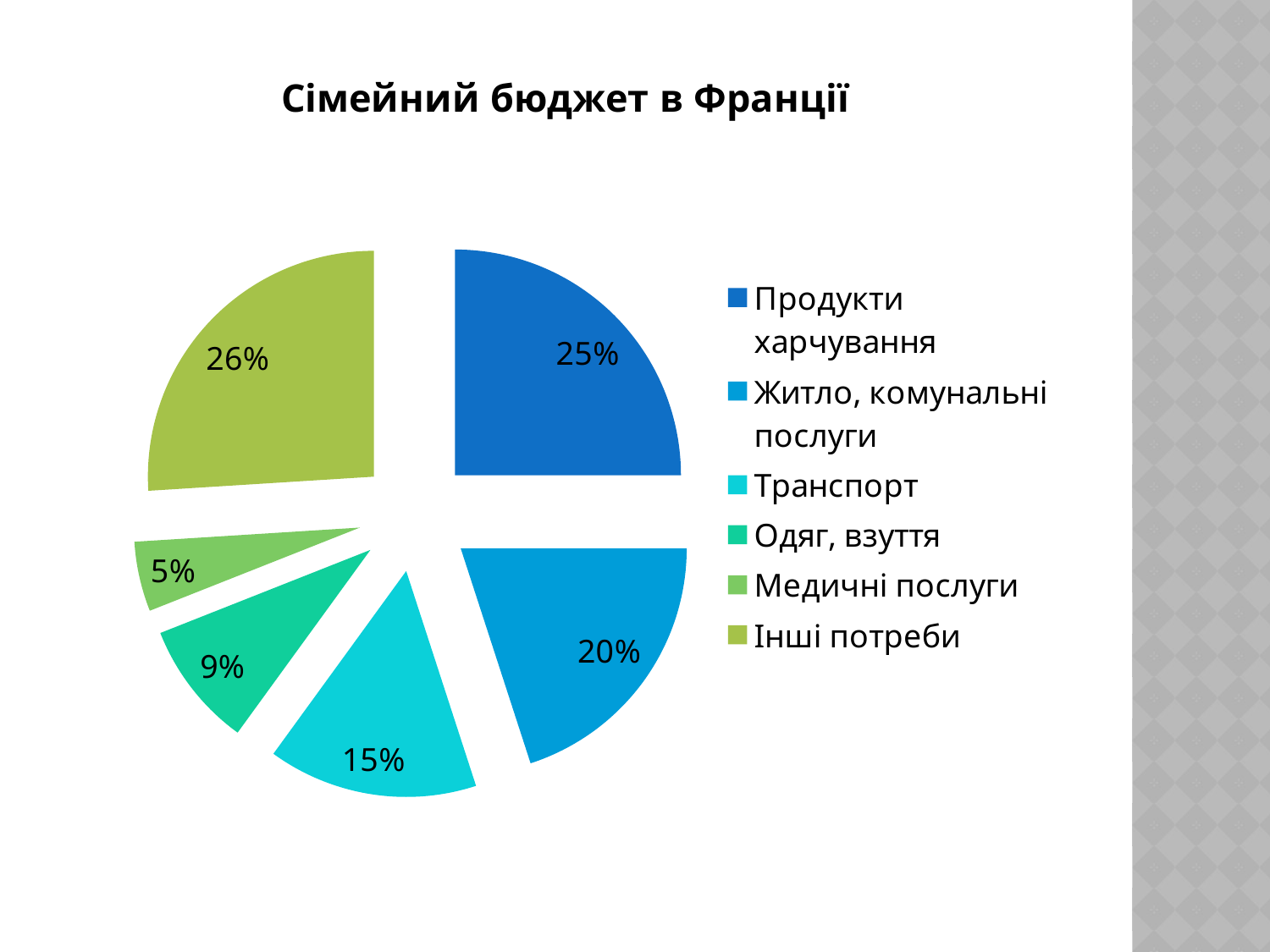
Which is larger, the share for Житло, комунальні послуги or the share for Одяг, взуття? Житло, комунальні послуги What share of the family budget goes to Житло, комунальні послуги? 20% What is the title of the chart? Сімейний бюджет в Франції Which category has the smallest share of the budget? Медичні послуги What is the difference between the shares for Продукти харчування and Транспорт? 10% What kind of chart is shown on the slide? pie chart What share of the family budget goes to Медичні послуги? 5% Which category has the largest share of the budget? Інші потреби What share of the family budget goes to Продукти харчування? 25% What share of the family budget goes to Транспорт? 15% How many categories does the legend list? 6 What share of the family budget goes to Одяг, взуття? 9%